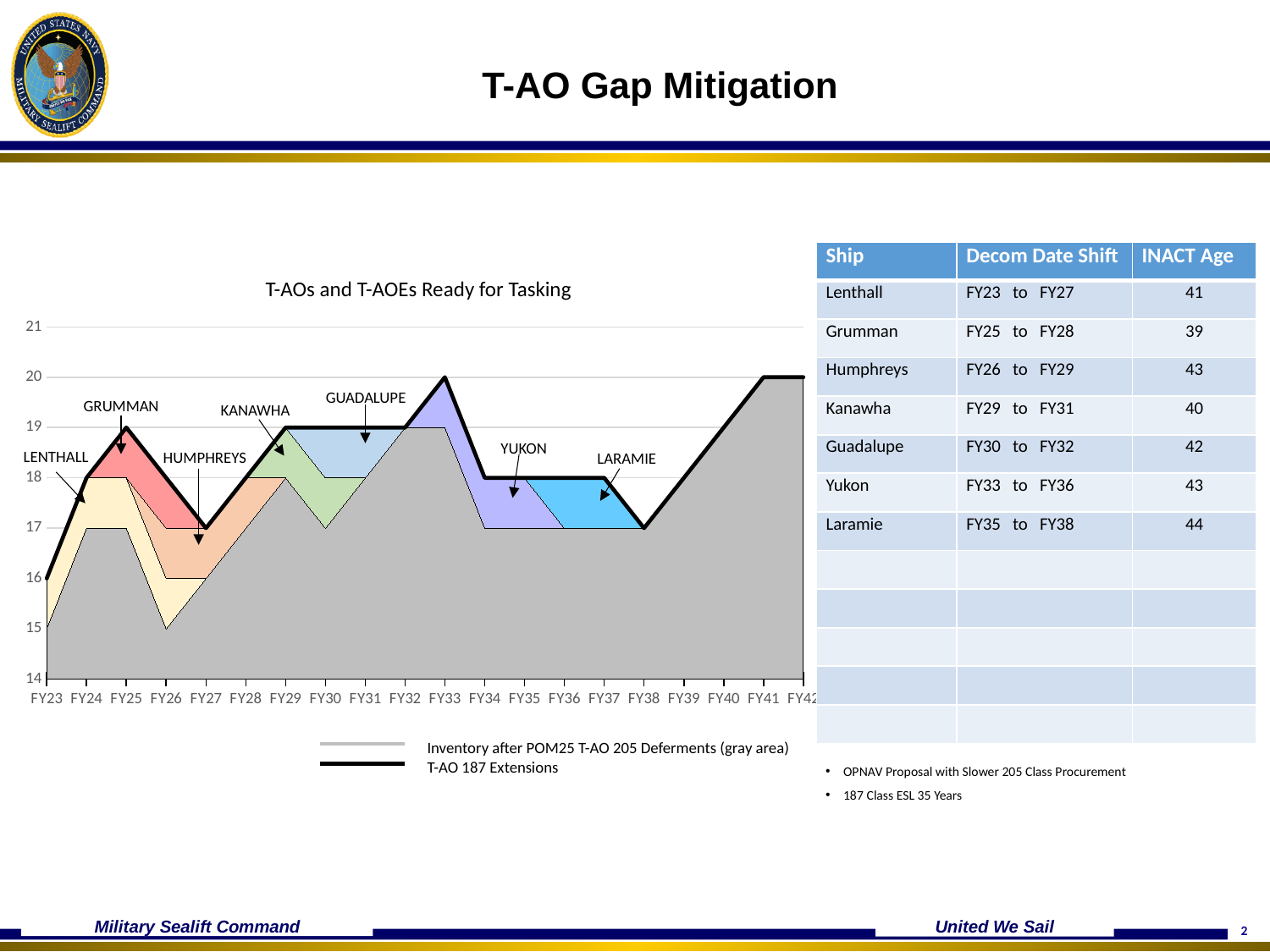
Does the T-AO 187 Extensions line rise or fall from FY38 to FY41? rise What value does the T-AO 187 Extensions line reach in FY33? 20 Which is higher on the T-AO 187 Extensions line, FY25 or FY27? FY25 What is the value of the gray area (Inventory after POM25 T-AO 205 Deferments) in FY26? 15 What is the first fiscal year shown on the x axis of the chart? FY23 What value does the T-AO 187 Extensions line have in FY23? 16 How many fiscal years are shown along the x axis of the chart? 20 What is the title of the chart on the slide? T-AOs and T-AOEs Ready for Tasking What is the difference between the T-AO 187 Extensions line values in FY25 and FY27? 2 Is the value of the gray area in FY26 greater or less than 16? less How many entries does the chart legend list? 2 What value does the T-AO 187 Extensions line have in FY27? 17